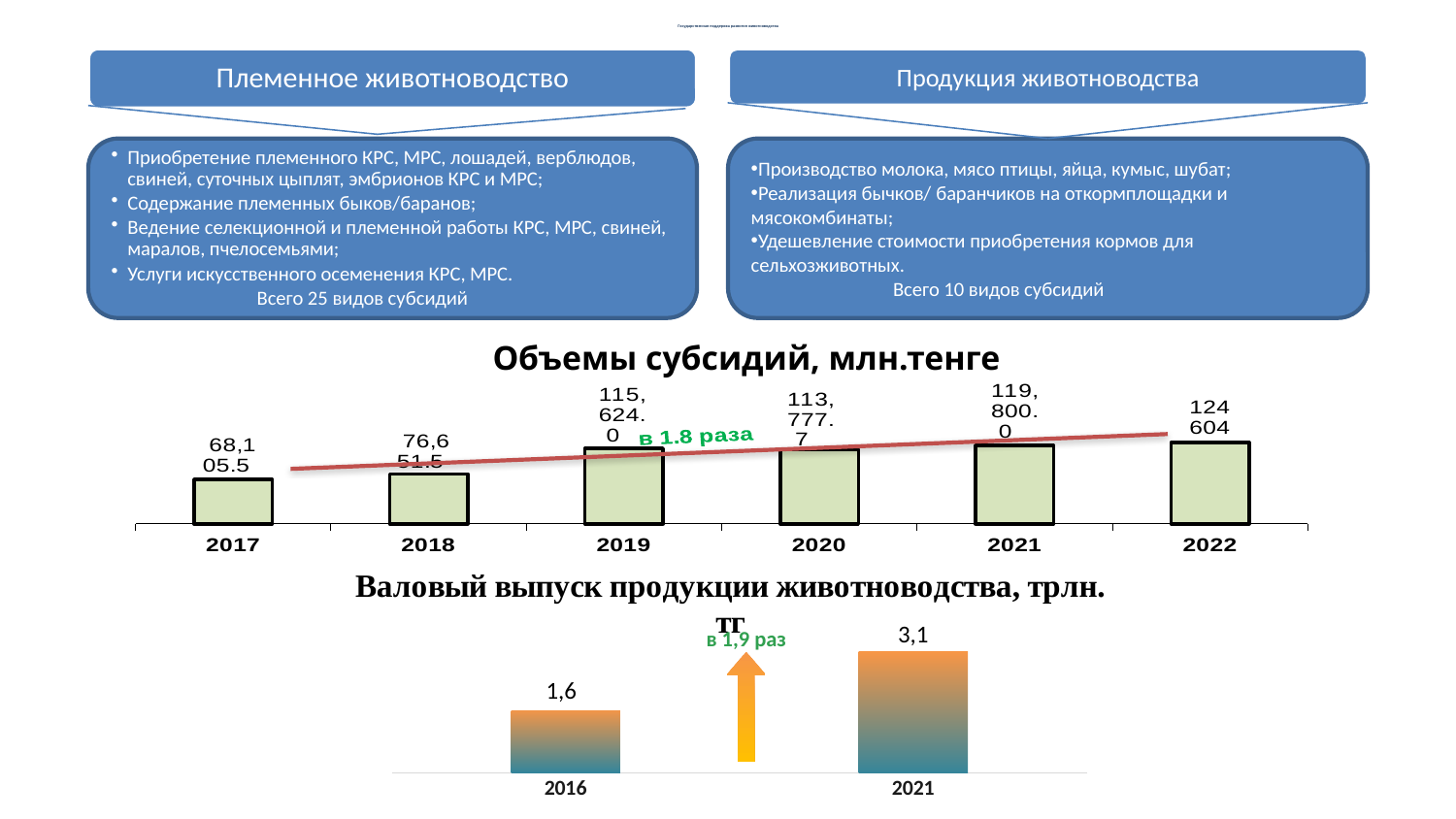
What kind of chart is 'Объемы субсидий, млн.тенге'? bar chart On the chart 'Валовый выпуск продукции животноводства, трлн. тг', what is the value for 2021? 3,1 On the chart 'Объемы субсидий, млн.тенге', which year has the lowest value? 2017 On the chart 'Объемы субсидий, млн.тенге', how many years are shown on the x axis? 6 On the chart 'Объемы субсидий, млн.тенге', which year has the highest value? 2022 On the chart 'Объемы субсидий, млн.тенге', which is larger, the value for 2019 or the value for 2020? 2019 On the chart 'Валовый выпуск продукции животноводства, трлн. тг', what growth factor is annotated between the two bars? в 1,9 раз On the chart 'Валовый выпуск продукции животноводства, трлн. тг', how many years are shown? 2 On the chart 'Валовый выпуск продукции животноводства, трлн. тг', what is the value for 2016? 1,6 On the chart 'Объемы субсидий, млн.тенге', what is the value for 2021? 119,800.0 On the chart 'Валовый выпуск продукции животноводства, трлн. тг', what is the difference between the 2021 and 2016 values? 1,5 On the chart 'Объемы субсидий, млн.тенге', what is the value for 2022? 124 604